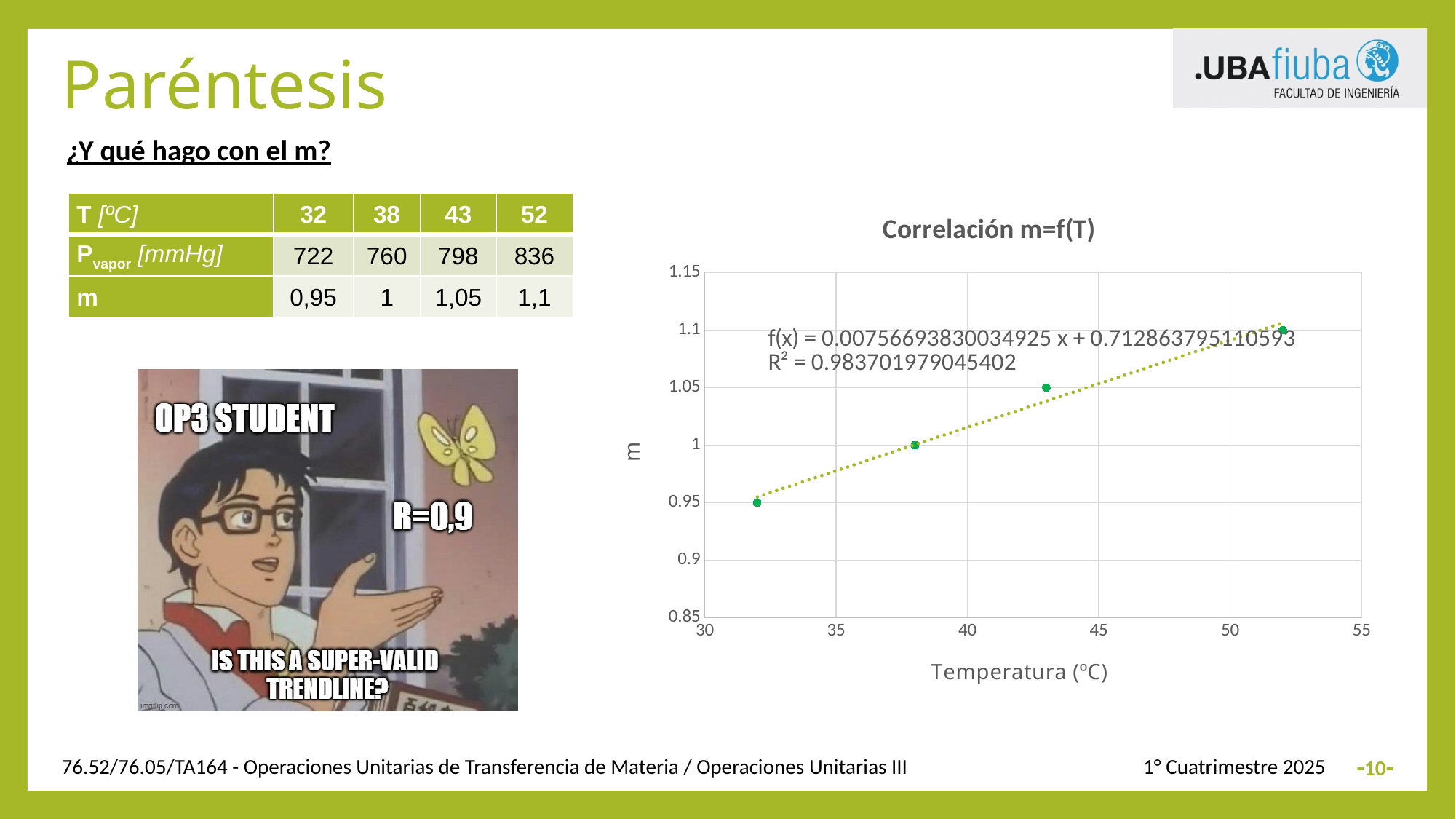
What is the lowest value of m plotted in the chart? 0.95 What is the difference between the highest and lowest plotted values of m? 0.15 How many data points are plotted in the chart? 4 What is the value of m at a temperature of 43 ºC? 1.05 What is the title of the chart? Correlación m=f(T) What is the highest value of m plotted in the chart? 1.1 What kind of chart is shown on the slide? scatter chart What is the label of the x axis of the chart? Temperatura (ºC) Is the value of m at 32 ºC greater or less than 1? less Do the values of m rise or fall as temperature increases along the x axis? rise What is the R² value shown on the chart for the trendline? 0.983701979045402 Which has a larger value of m: the point at 38 ºC or the point at 52 ºC? 52 ºC